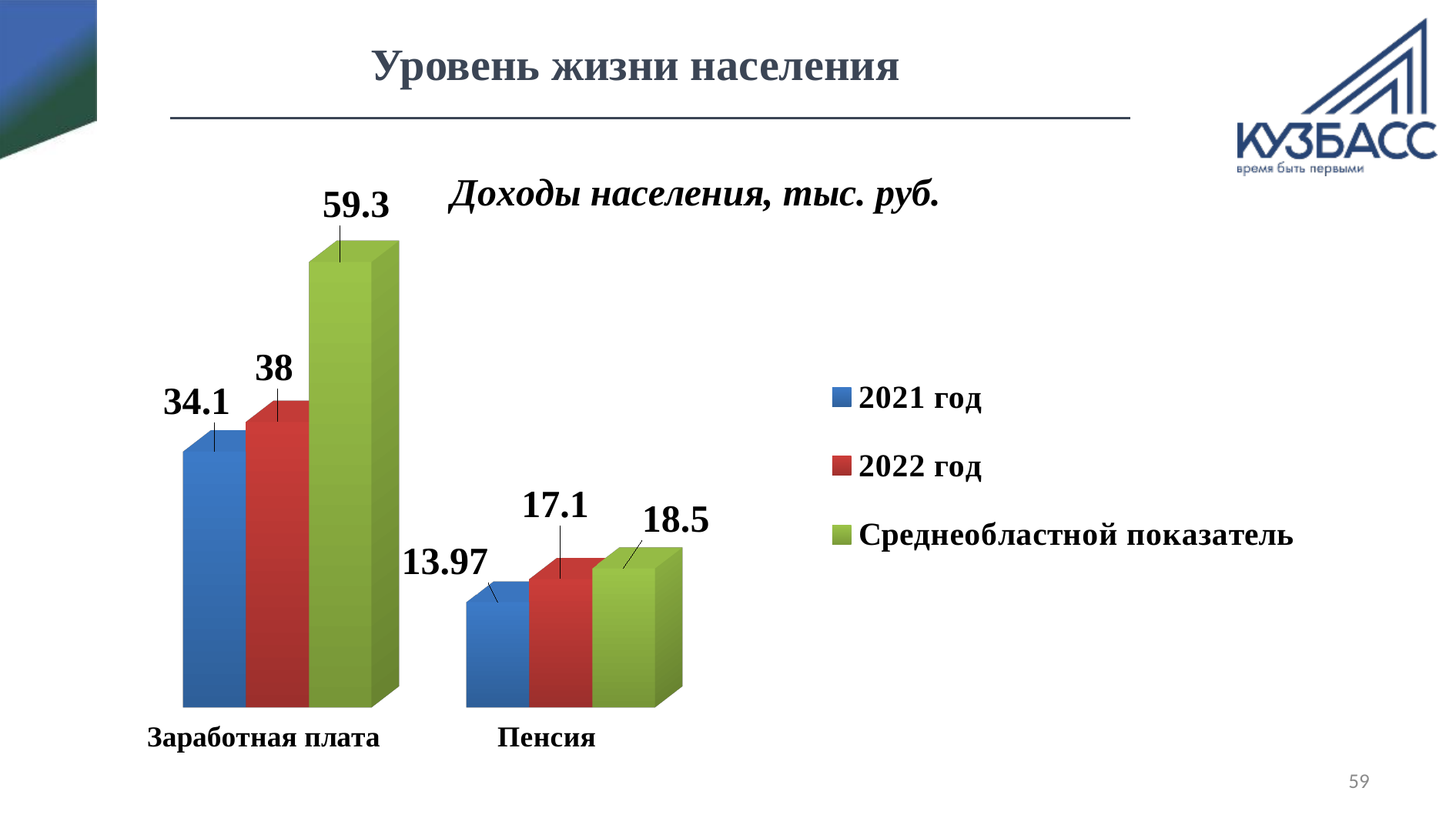
How many series does the legend list? 3 What kind of chart is shown on the slide? Bar chart What is the difference between the 2022 год and 2021 год values for Заработная плата? 3.9 What is the value for Заработная плата in the 2021 год series? 34.1 Which series has the lowest value for Пенсия? 2021 год What is the difference between the Среднеобластной показатель and 2022 год values for Пенсия? 1.4 What is the value for Пенсия in the 2022 год series? 17.1 Which is larger: the 2022 год value for Заработная плата or the Среднеобластной показатель value for Пенсия? 2022 год value for Заработная плата What is the value for Пенсия in the 2021 год series? 13.97 How many categories are shown on the x axis? 2 Which series has the highest value for Заработная плата? Среднеобластной показатель What is the Среднеобластной показатель value for Заработная плата? 59.3